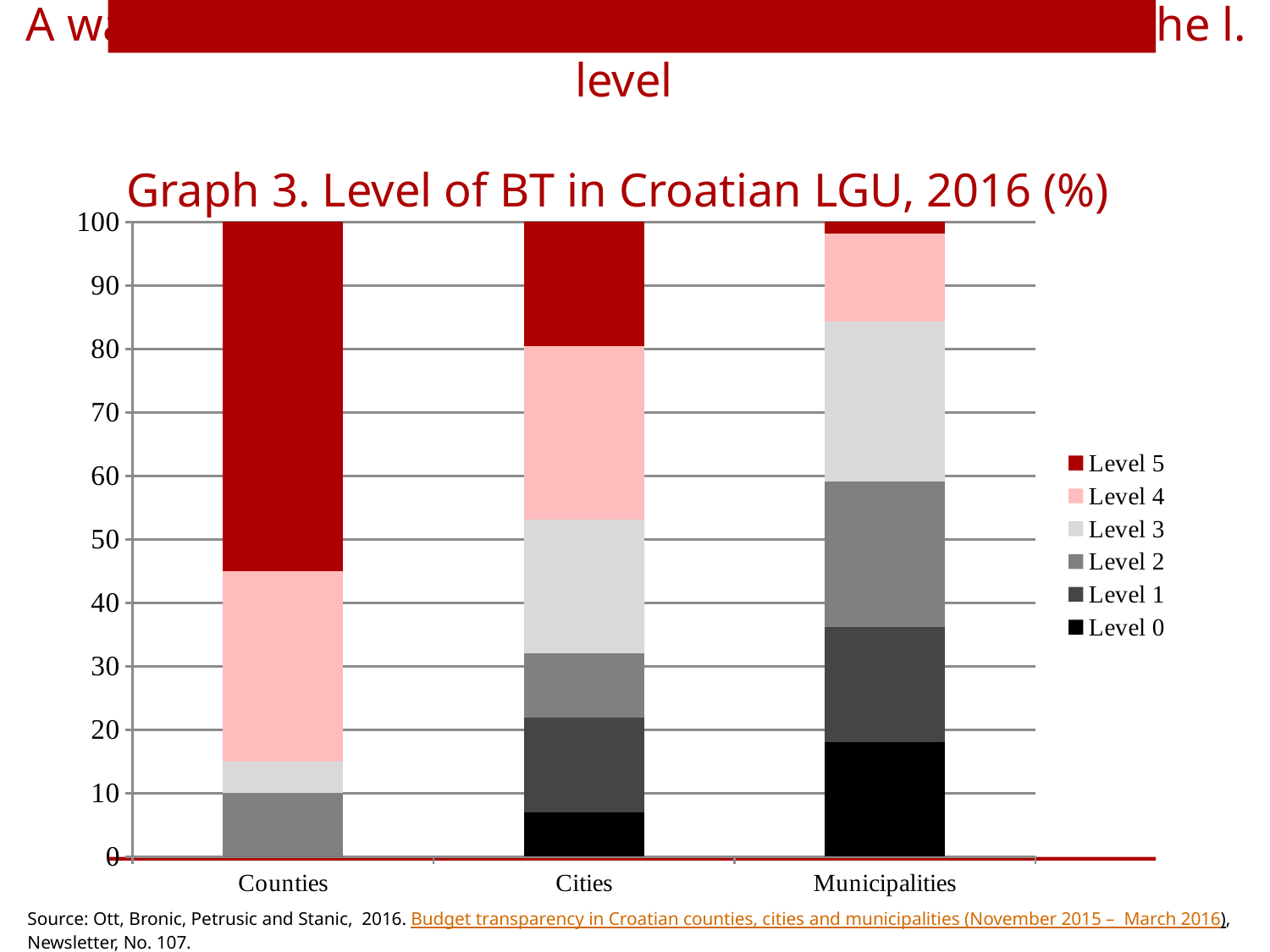
Which has the larger Level 0 share, Cities or Municipalities? Municipalities What kind of chart is shown on the slide? Stacked bar chart Which legend entry is shown in dark red? Level 5 How many series does the chart's legend list? 6 Is the Level 0 share for Municipalities greater or less than 10? greater Is the Level 5 share for Counties greater or less than 50? greater How many categories are shown on the x axis of the chart? 3 Is the Level 5 share for Municipalities greater or less than 10? less Which category has the largest Level 5 share? Counties What is the total height of the Counties stacked bar? 100 What is the title of the chart? Graph 3. Level of BT in Croatian LGU, 2016 (%)